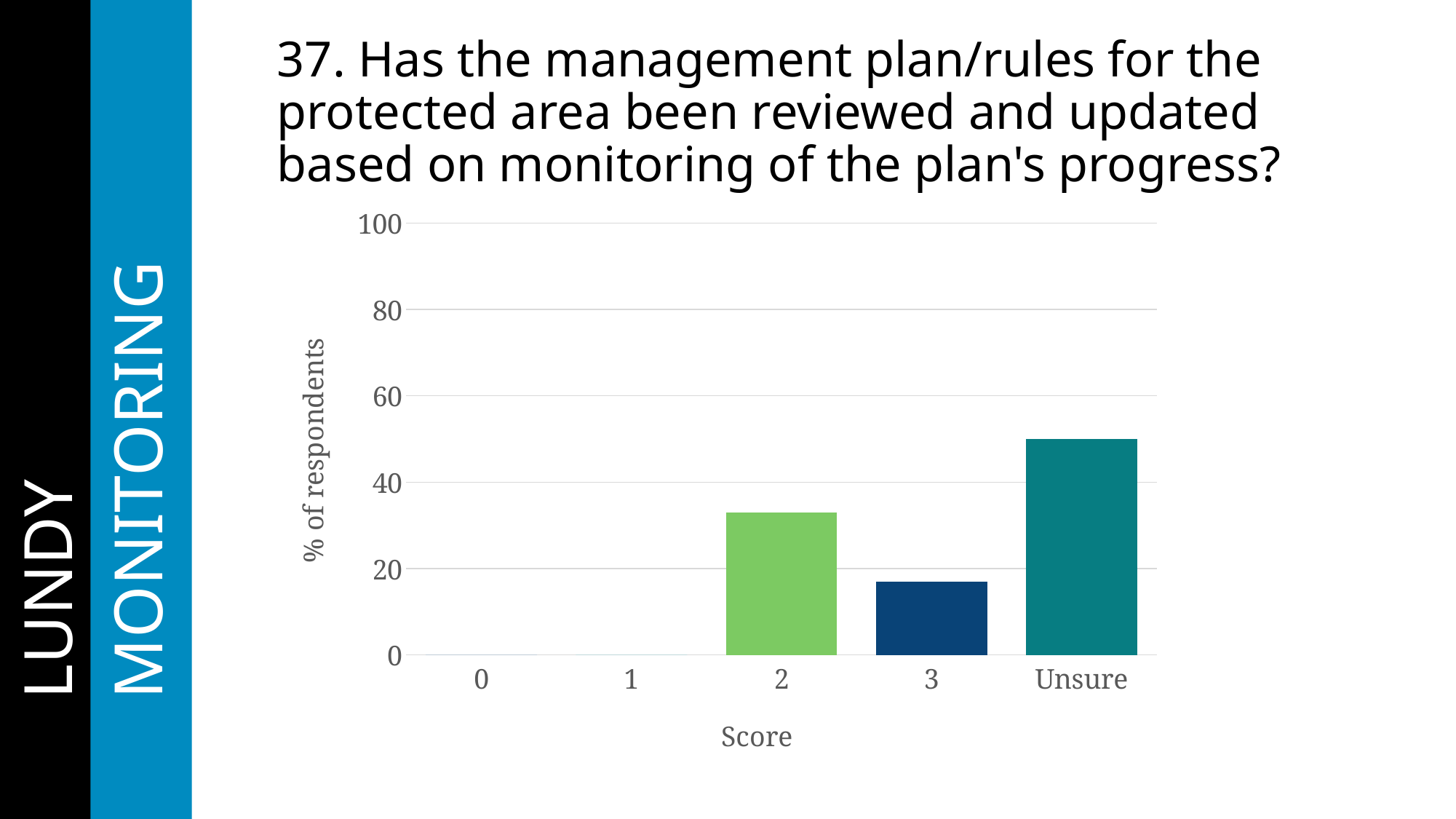
Which category has the highest value in the chart? Unsure What is the label of the x axis of the chart? Score How many categories are shown on the x axis of the chart? 5 What is the label of the y axis of the chart? % of respondents Is the value for score 2 greater or less than 20? greater Which is larger, the value for score 2 or the value for score 3? score 2 What kind of chart is shown on the slide? bar chart Is the value for score 2 greater or less than 40? less Is the value for Unsure greater or less than 40? greater What is the value for score 0 in the chart? 0